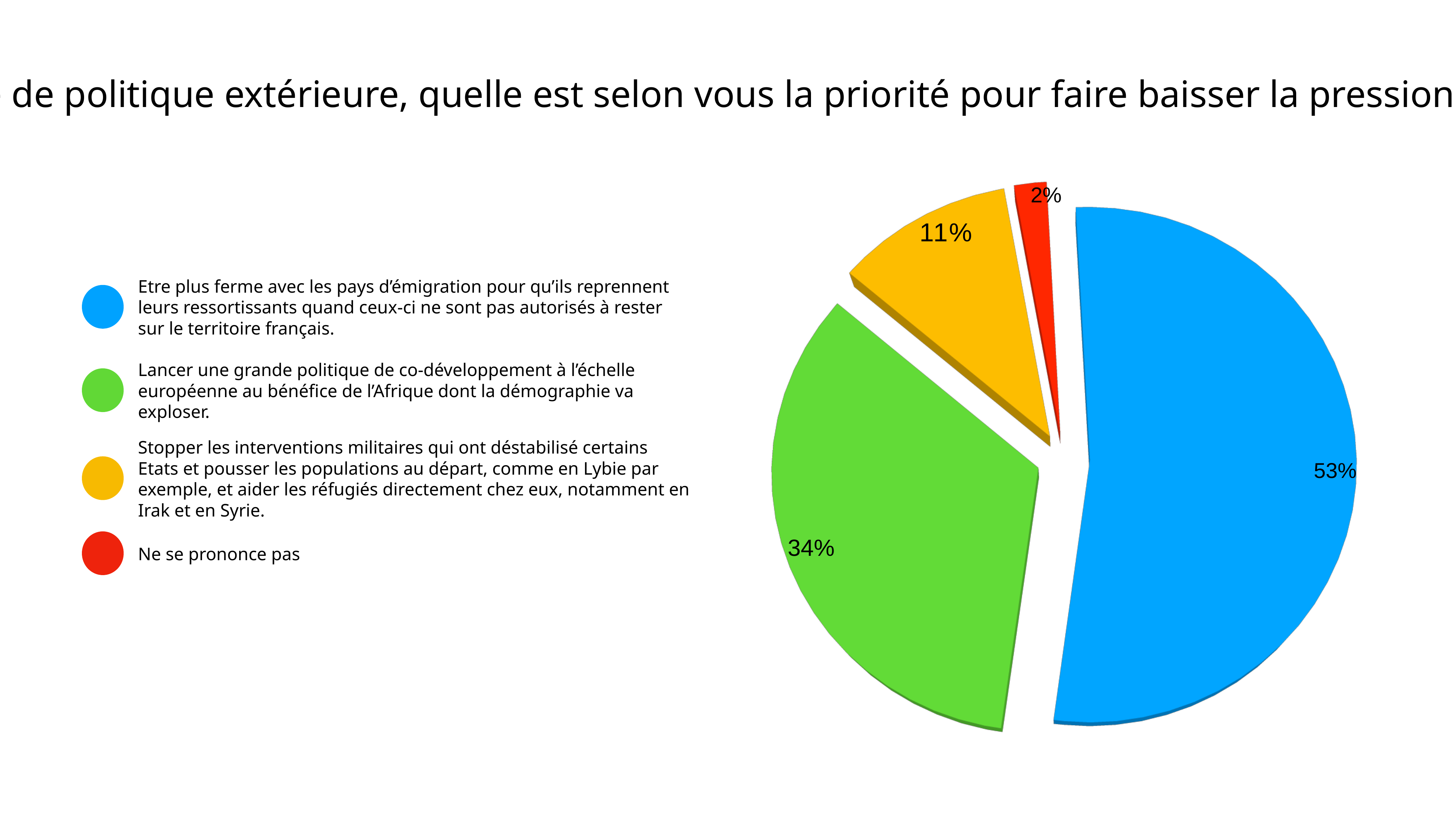
What percentage is shown for the green slice, 'Lancer une grande politique de co-développement...'? 34% Which response has the smallest share of the pie? Ne se prononce pas What kind of chart is shown on the slide? Pie chart What colour is the slice for 'Ne se prononce pas'? Red Which is larger: the share for 'Lancer une grande politique de co-développement...' or the share for 'Stopper les interventions militaires...'? Lancer une grande politique de co-développement à l'échelle européenne au bénéfice de l'Afrique dont la démographie va exploser. What is the difference in percentage points between the blue slice (53%) and the green slice (34%)? 19 What percentage is shown for the blue slice, 'Etre plus ferme avec les pays d'émigration...'? 53% How many slices does the pie chart have? 4 What percentage is shown for 'Ne se prononce pas'? 2% What is the difference in percentage points between the yellow slice (11%) and the red slice (2%)? 9 Which response has the largest share of the pie? Etre plus ferme avec les pays d'émigration pour qu'ils reprennent leurs ressortissants quand ceux-ci ne sont pas autorisés à rester sur le territoire français. What percentage is shown for the yellow slice, 'Stopper les interventions militaires...'? 11%